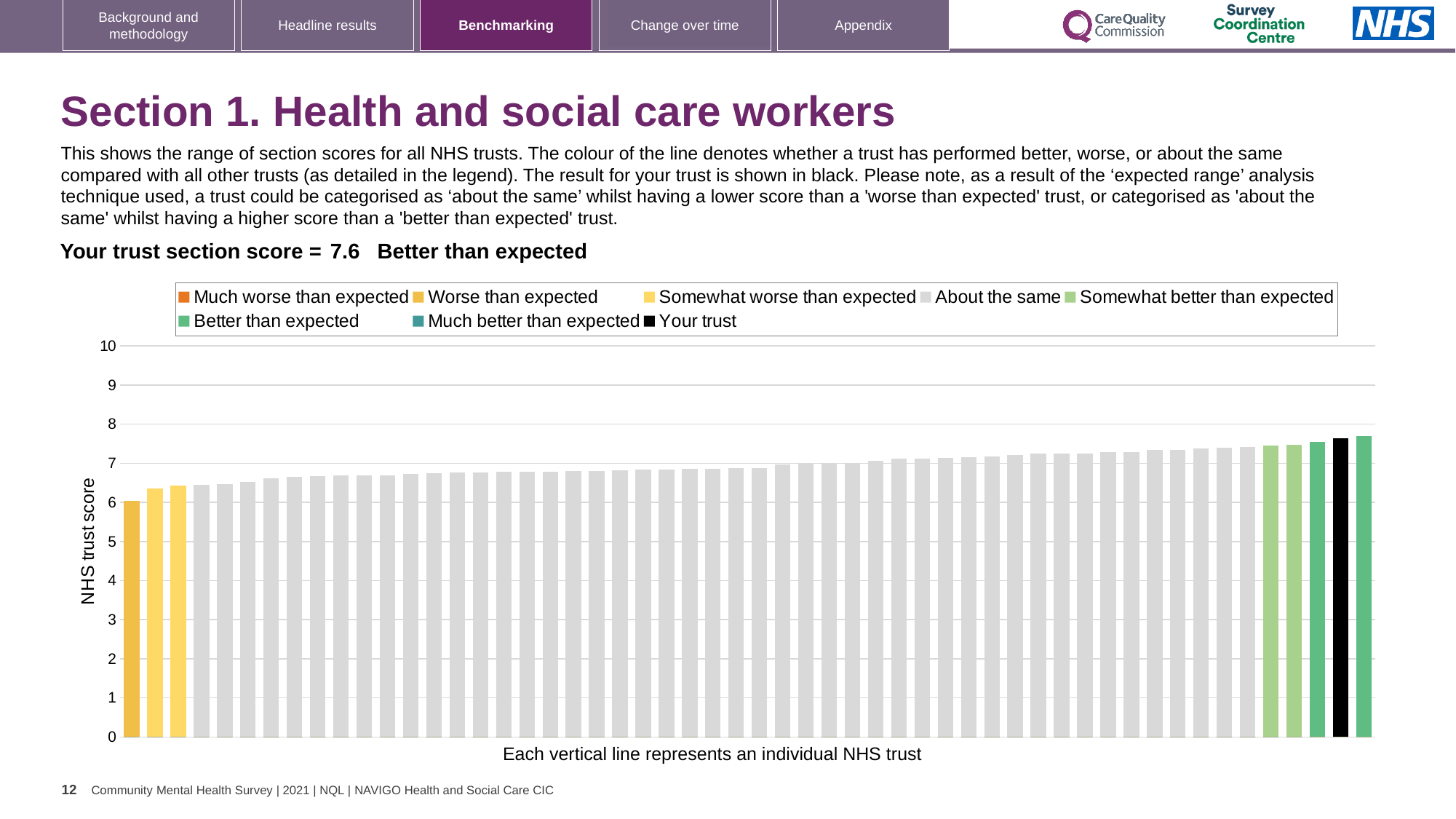
What kind of chart is shown on the slide? Bar chart How many bars are coloured as 'Worse than expected' (yellow)? 1 What is the label on the y axis of the chart? NHS trust score Which is larger: the value of the black 'Your trust' bar or the leftmost bar? The black 'Your trust' bar What colour is used for the bar representing your trust? Black What is the section score for your trust shown on the slide? 7.6 Is the value of the rightmost bar greater or less than 8? less Which category is your trust placed in for this section? Better than expected How many entries does the chart legend list? 8 Is the value of the black 'Your trust' bar greater or less than 7? greater Do the bar values rise or fall from left to right along the x axis? Rise Is the value of the leftmost (lowest) bar greater or less than 7? less